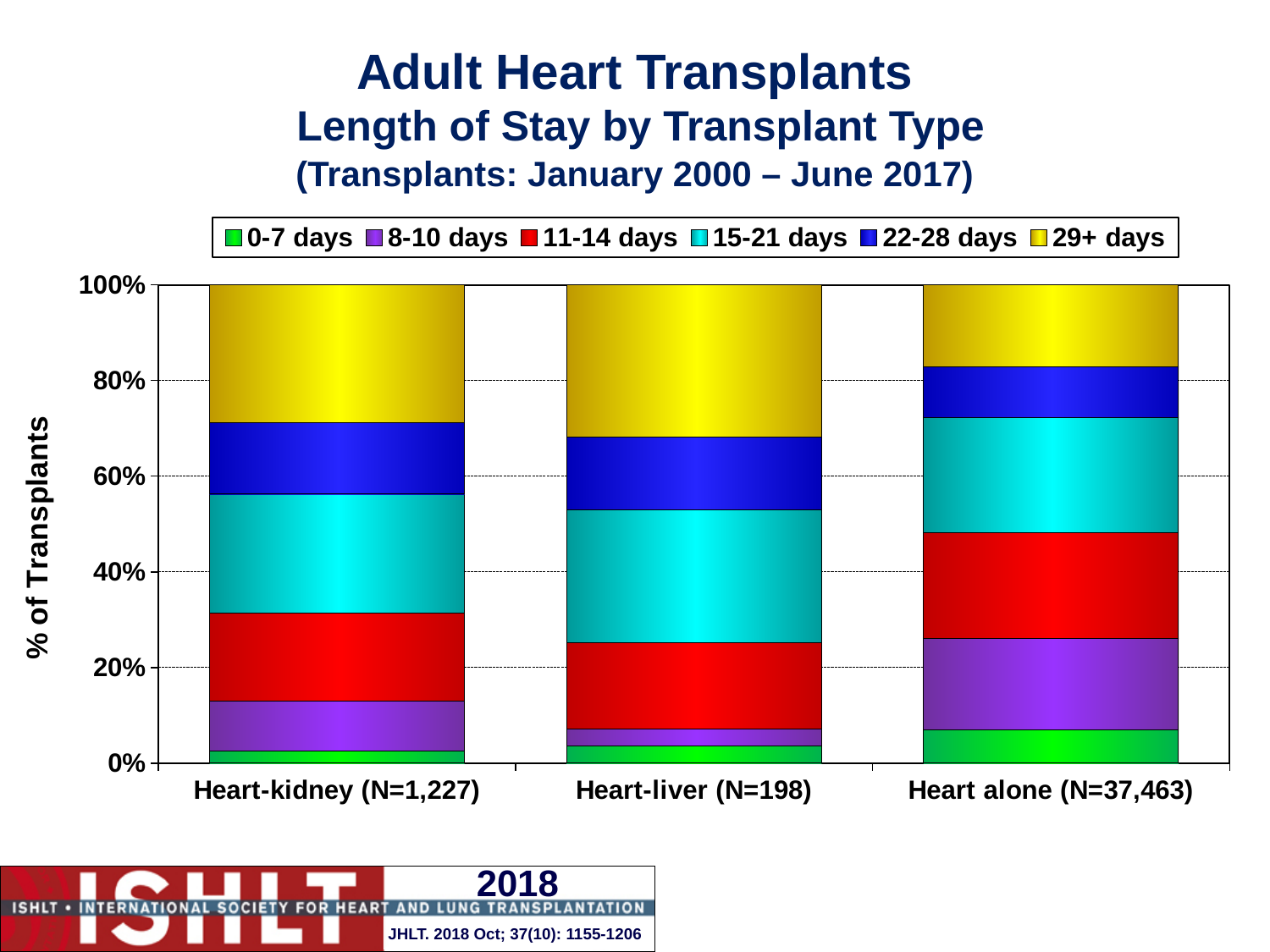
Which has the larger 8-10 days share, Heart alone or Heart-liver? Heart alone Is the 8-10 days share for Heart-liver greater or less than 10%? less How many length-of-stay categories does the legend list? 6 Is the 29+ days share for Heart alone greater or less than 20%? less Which transplant type has the smallest 8-10 days share? Heart-liver What is the N shown for Heart alone on the x axis? N=37,463 Is the 8-10 days share for Heart alone greater or less than 10%? greater How many transplant types are shown along the x axis? 3 What kind of chart is shown on the slide? Stacked bar chart Which has the larger 29+ days share, Heart-liver or Heart alone? Heart-liver What is the label on the y axis? % of Transplants